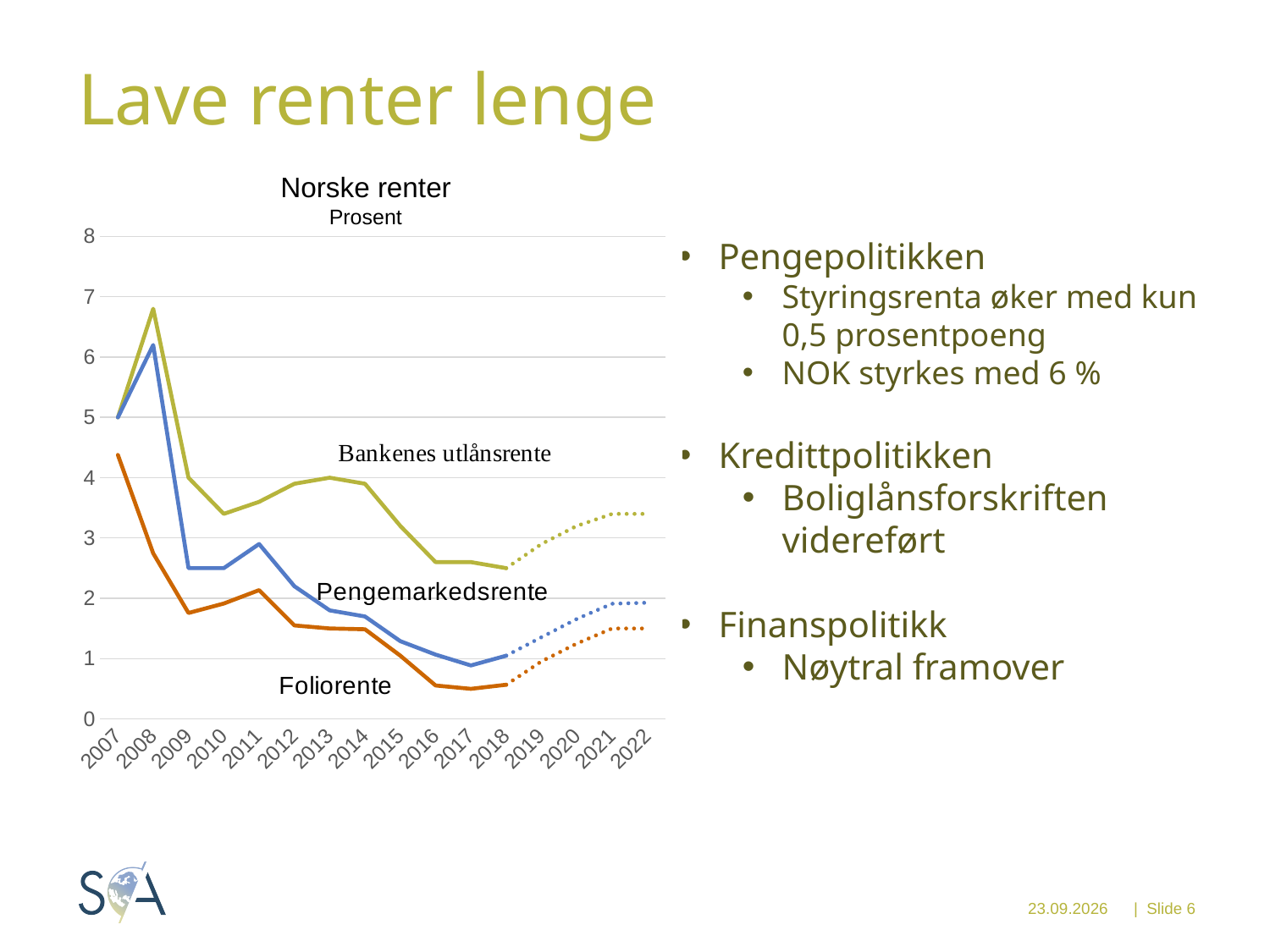
Do the Foliorente values rise or fall from 2007 to 2017? fall Which series has the lowest values across the whole period? Foliorente Is the value for Bankenes utlånsrente in 2008 greater or less than 6? greater What kind of chart is shown on the slide? Line chart How many years are shown on the x axis? 16 How many series are plotted in the chart? 3 Which is larger: Foliorente in 2007 or Foliorente in 2017? Foliorente in 2007 In which year is Bankenes utlånsrente at its highest? 2008 What unit is given in the chart's subtitle? Prosent Is the value for Foliorente in 2017 greater or less than 1? less What is the title of the chart? Norske renter Is the value for Bankenes utlånsrente in 2016 greater or less than 3? less